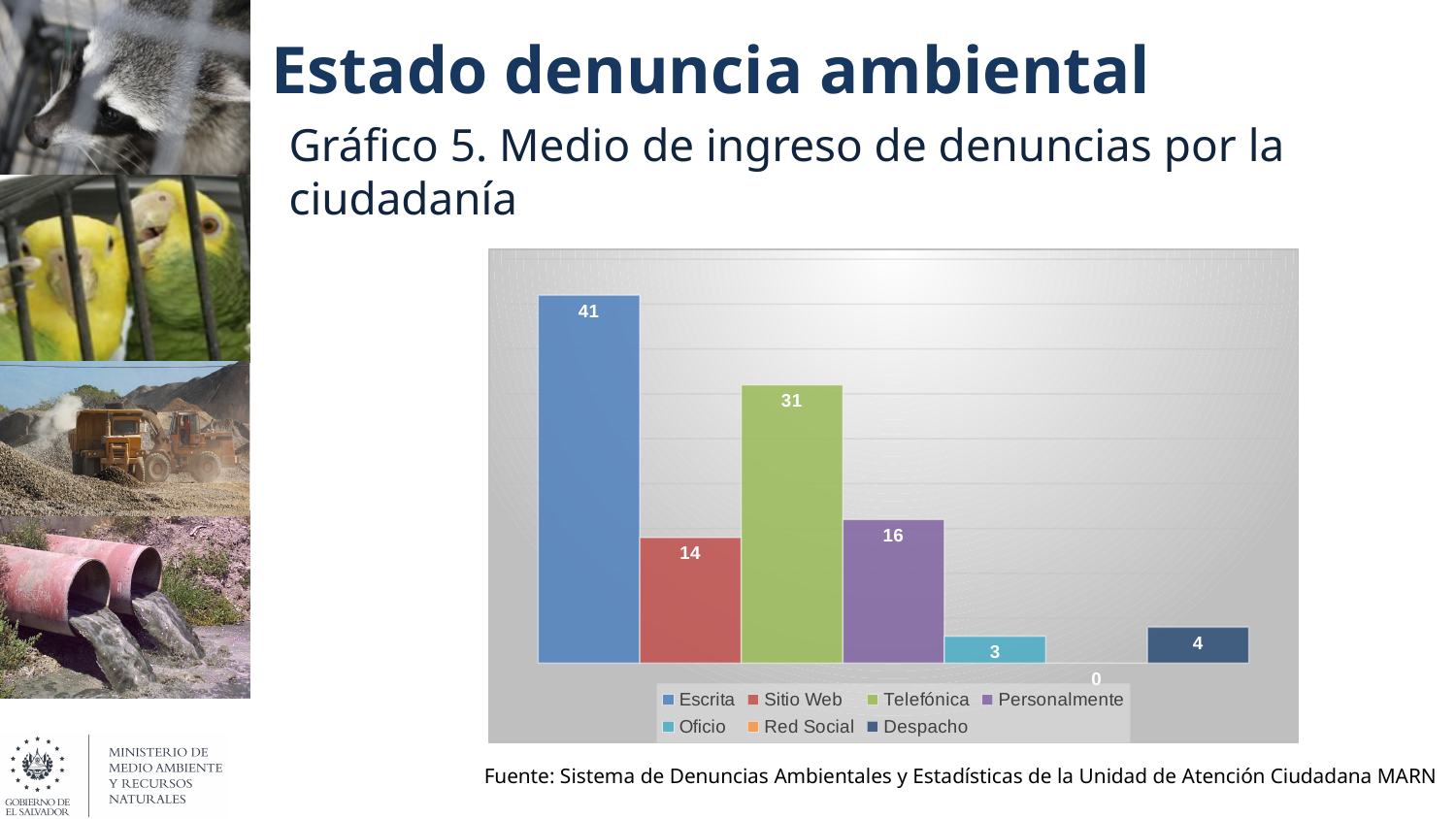
What is the value for Escrita? 41 Which category has the lowest value? Red Social What is the title of the chart? Gráfico 5. Medio de ingreso de denuncias por la ciudadanía What is the difference between the values for Personalmente and Sitio Web? 2 Which is larger, the value for Despacho or the value for Oficio? Despacho Which category has the highest value? Escrita What is the value for Personalmente? 16 What is the value for Red Social? 0 What is the value for Telefónica? 31 What kind of chart is shown on the slide? Bar chart What is the difference between the values for Escrita and Telefónica? 10 How many series does the legend list? 7